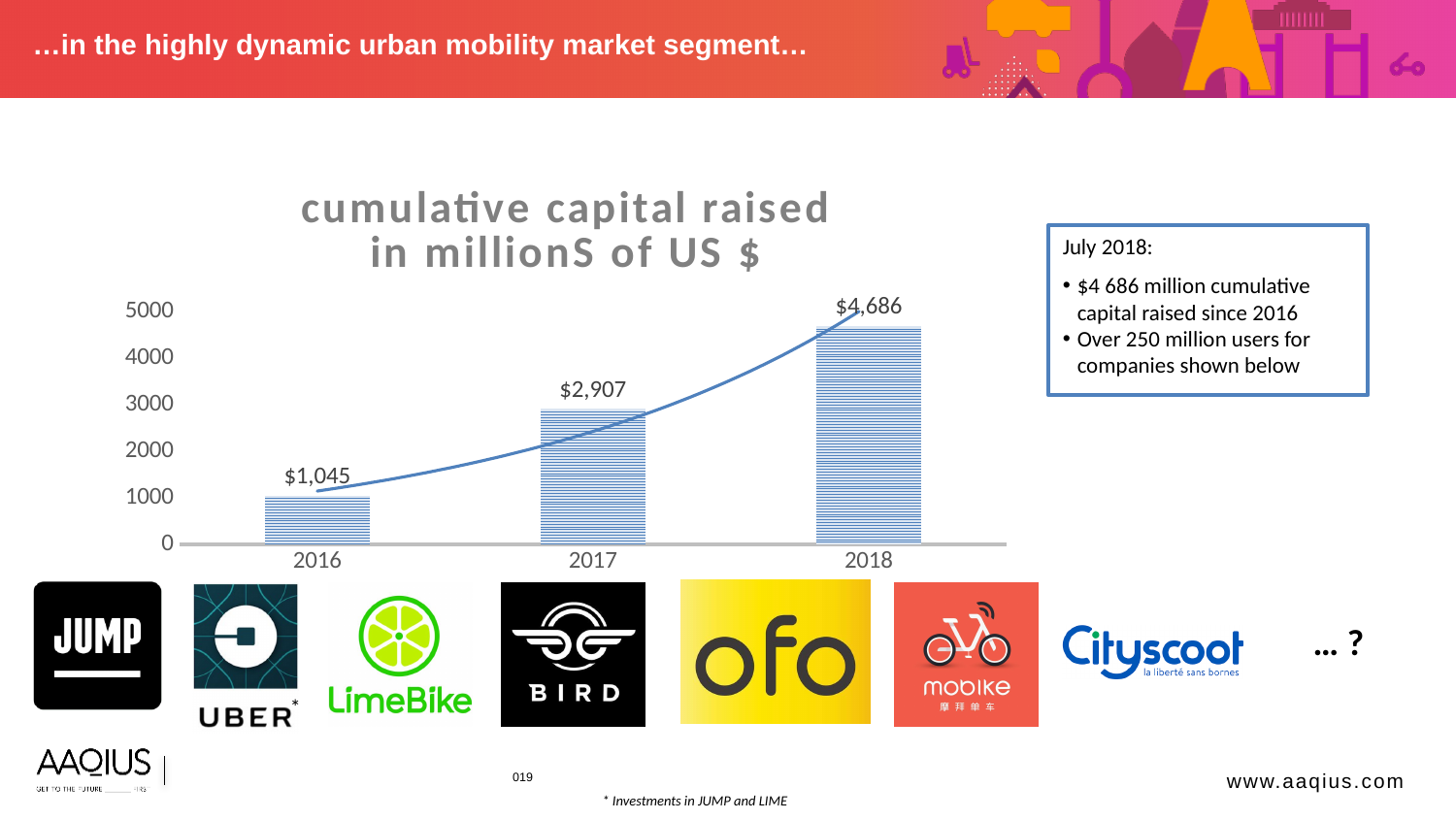
Which year has the lowest cumulative capital raised? 2016 What is the cumulative capital raised shown for 2018? $4,686 What is the difference between the 2017 and 2016 values? $1,862 How many years are shown on the x axis of the chart? 3 What is the cumulative capital raised shown for 2017? $2,907 Which is larger, the value for 2017 or the value for 2016? 2017 Do the values rise or fall from 2016 to 2018? rise What is the difference between the 2018 and 2017 values? $1,779 What is the cumulative capital raised shown for 2016? $1,045 Which year has the highest cumulative capital raised? 2018 Is the value for 2018 greater or less than 4000? greater What kind of chart is used to show the cumulative capital raised? bar chart